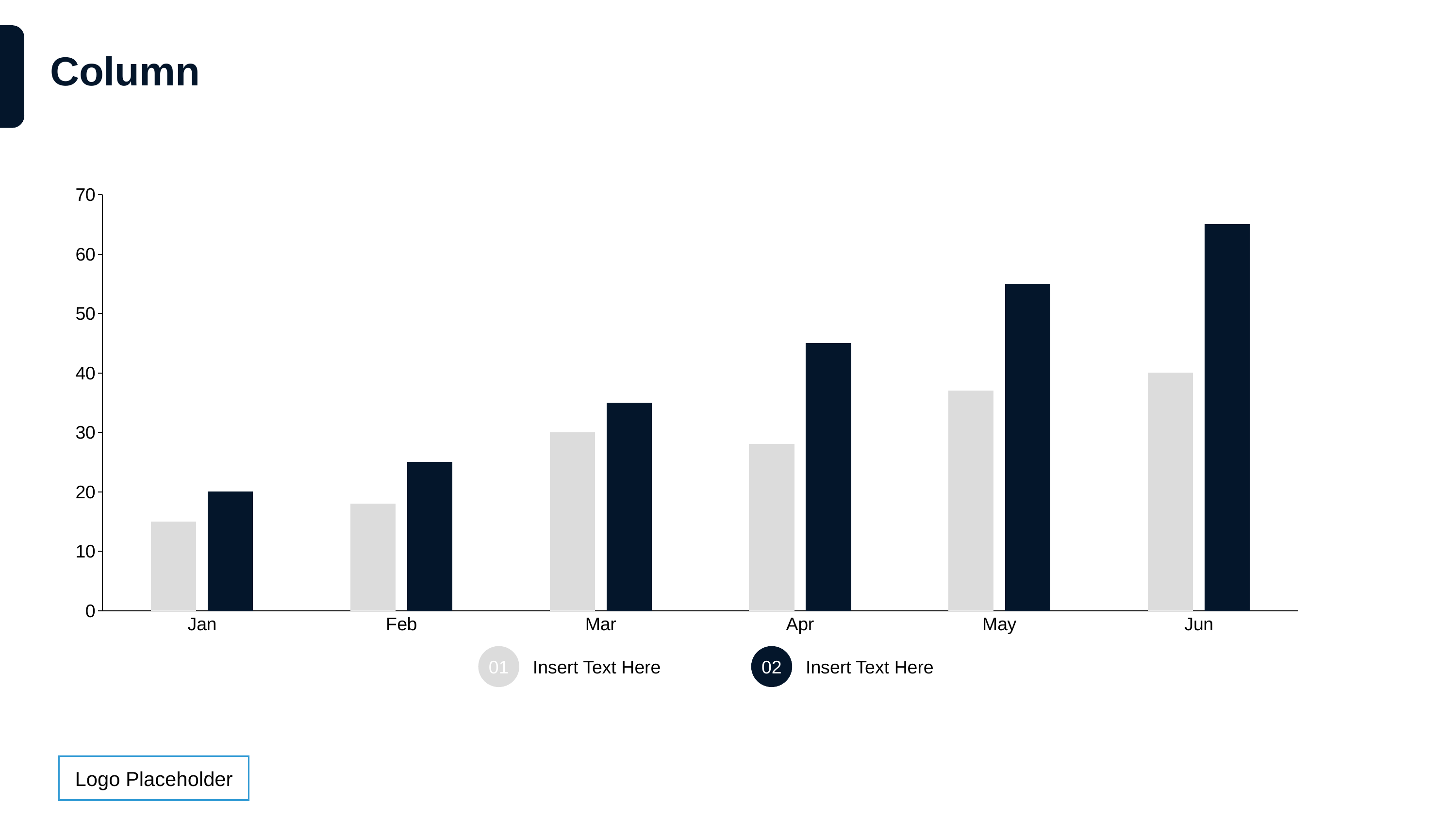
Is the value of the dark navy series (02) for Jun greater or less than 60? greater What kind of chart is shown on the slide? bar chart How many series does the chart's legend list? 2 Do the values of the dark navy series (02) rise or fall from Jan to Jun? rise What is the value of the light grey series (01) for Jun? 40 In which month is the light grey series (01) lowest? Jan What is the value of the dark navy series (02) for Jan? 20 In which month is the dark navy series (02) highest? Jun How many months are shown on the x axis of the chart? 6 Which is larger in Jun: the light grey series (01) or the dark navy series (02)? the dark navy series (02) Is the value of the light grey series (01) for Apr greater or less than 30? less What is the value of the light grey series (01) for Mar? 30